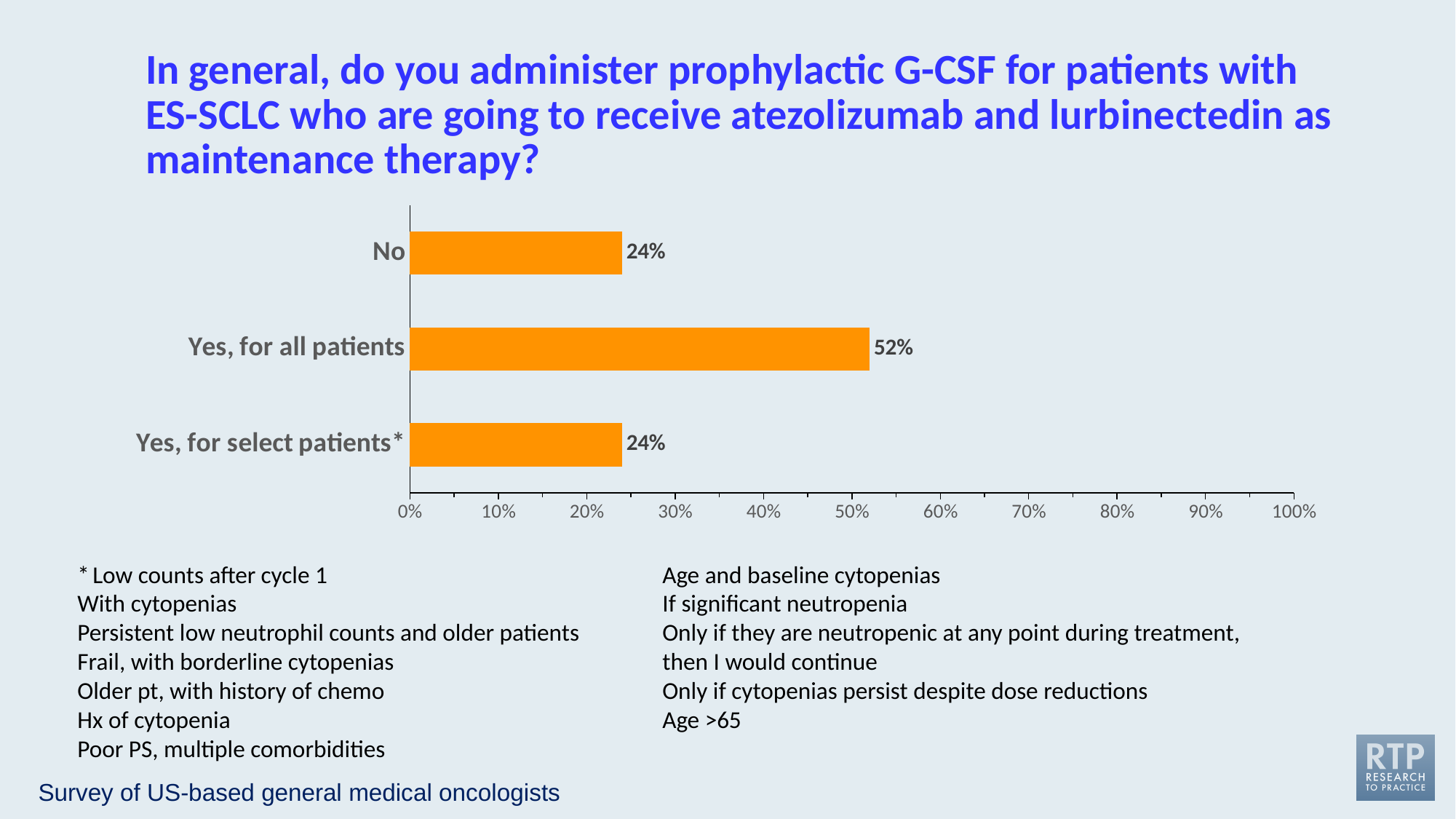
What is the maximum value shown on the x axis? 100% What kind of chart is shown on the slide? Bar chart What percentage of respondents answered "Yes, for all patients"? 52% How many response categories are shown in the chart? 3 What percentage of respondents answered "Yes, for select patients*"? 24% Which response category has the highest percentage? Yes, for all patients What percentage of respondents answered "No"? 24% Is the value for "No" greater or less than 30%? less What is the difference in percentage points between "Yes, for all patients" and "No"? 28 Which is larger, the value for "Yes, for all patients" or the value for "Yes, for select patients*"? Yes, for all patients What colour are the bars in the chart? Orange Is the value for "Yes, for all patients" greater or less than 50%? greater